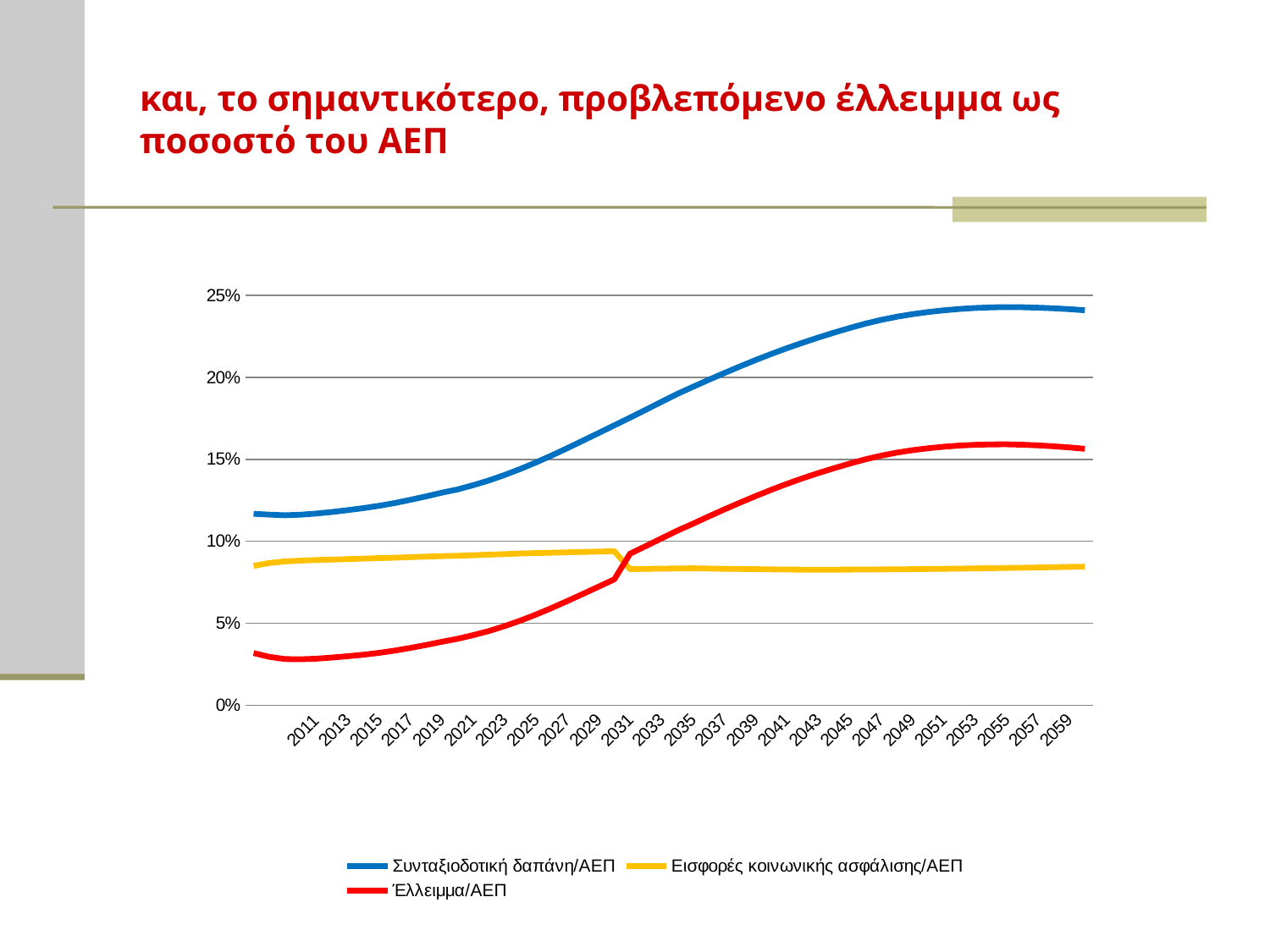
Does the Συνταξιοδοτική δαπάνη/ΑΕΠ line rise or fall overall from 2011 to 2059? rise In 2011, which is larger: Εισφορές κοινωνικής ασφάλισης/ΑΕΠ or Έλλειμμα/ΑΕΠ? Εισφορές κοινωνικής ασφάλισης/ΑΕΠ Is the value for Συνταξιοδοτική δαπάνη/ΑΕΠ in 2059 greater or less than 20%? greater What is the highest value shown on the vertical axis? 25% What colour is the line for Έλλειμμα/ΑΕΠ? red Is the value for Έλλειμμα/ΑΕΠ in 2011 greater or less than 5%? less Is the value for Έλλειμμα/ΑΕΠ in 2059 greater or less than 10%? greater How many series does the legend list? 3 Does the Έλλειμμα/ΑΕΠ line rise or fall overall from 2011 to 2059? rise What kind of chart is shown on the slide? line chart